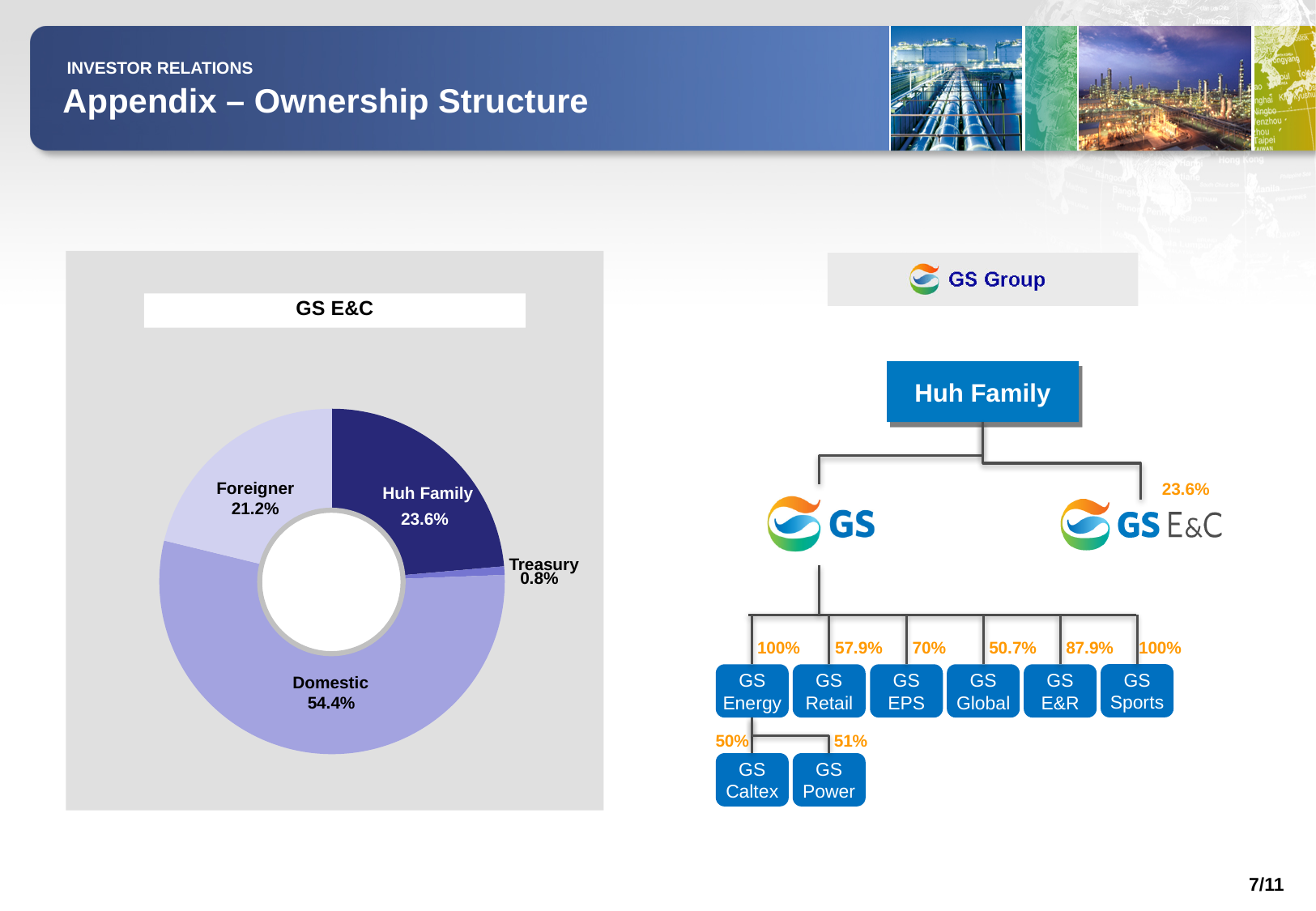
In the GS E&C pie chart, how much larger is the Domestic share than the Foreigner share? 33.2% Which category holds the largest share of GS E&C in the pie chart? Domestic What share of GS E&C is held by Domestic shareholders according to the pie chart? 54.4% What is the title of the pie chart on the slide? GS E&C Which category holds the smallest share of GS E&C in the pie chart? Treasury What type of chart is used to show the GS E&C ownership structure? Pie chart What share of GS E&C is held by the Huh Family according to the pie chart? 23.6% What share of GS E&C is Treasury stock according to the pie chart? 0.8% How many categories are shown in the GS E&C pie chart? 4 In the GS E&C pie chart, what is the difference between the Huh Family share and the Foreigner share? 2.4% What share of GS E&C is held by Foreigners according to the pie chart? 21.2% In the GS E&C pie chart, which is larger: the Huh Family share or the Foreigner share? Huh Family